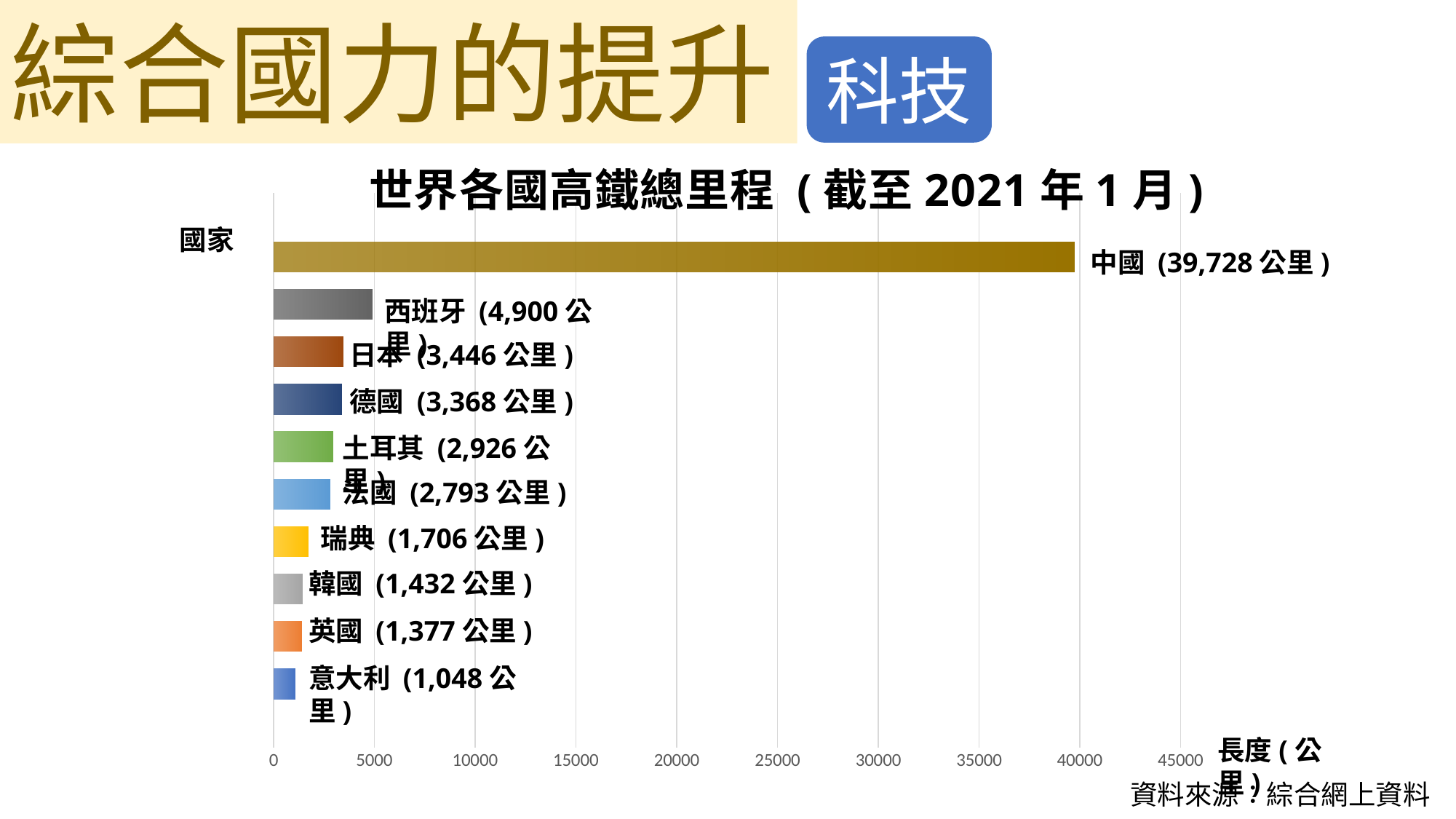
What is the high-speed rail length shown for 中國? 39,728 公里 Which country has the longest high-speed rail mileage in the chart? 中國 What is the difference in high-speed rail length between 西班牙 and 日本? 1,454 公里 What is the high-speed rail length shown for 瑞典? 1,706 公里 Which country has the shortest high-speed rail mileage in the chart? 意大利 What is the high-speed rail length shown for 德國? 3,368 公里 Is the value for 中國 greater or less than 35000? greater How many countries are shown in the chart? 10 What is the label of the horizontal axis? 長度 ( 公里 ) What type of chart is shown on the slide? bar chart What is the title of the chart? 世界各國高鐵總里程（截至 2021 年 1 月） Which has a longer high-speed rail network, 韓國 or 英國? 韓國